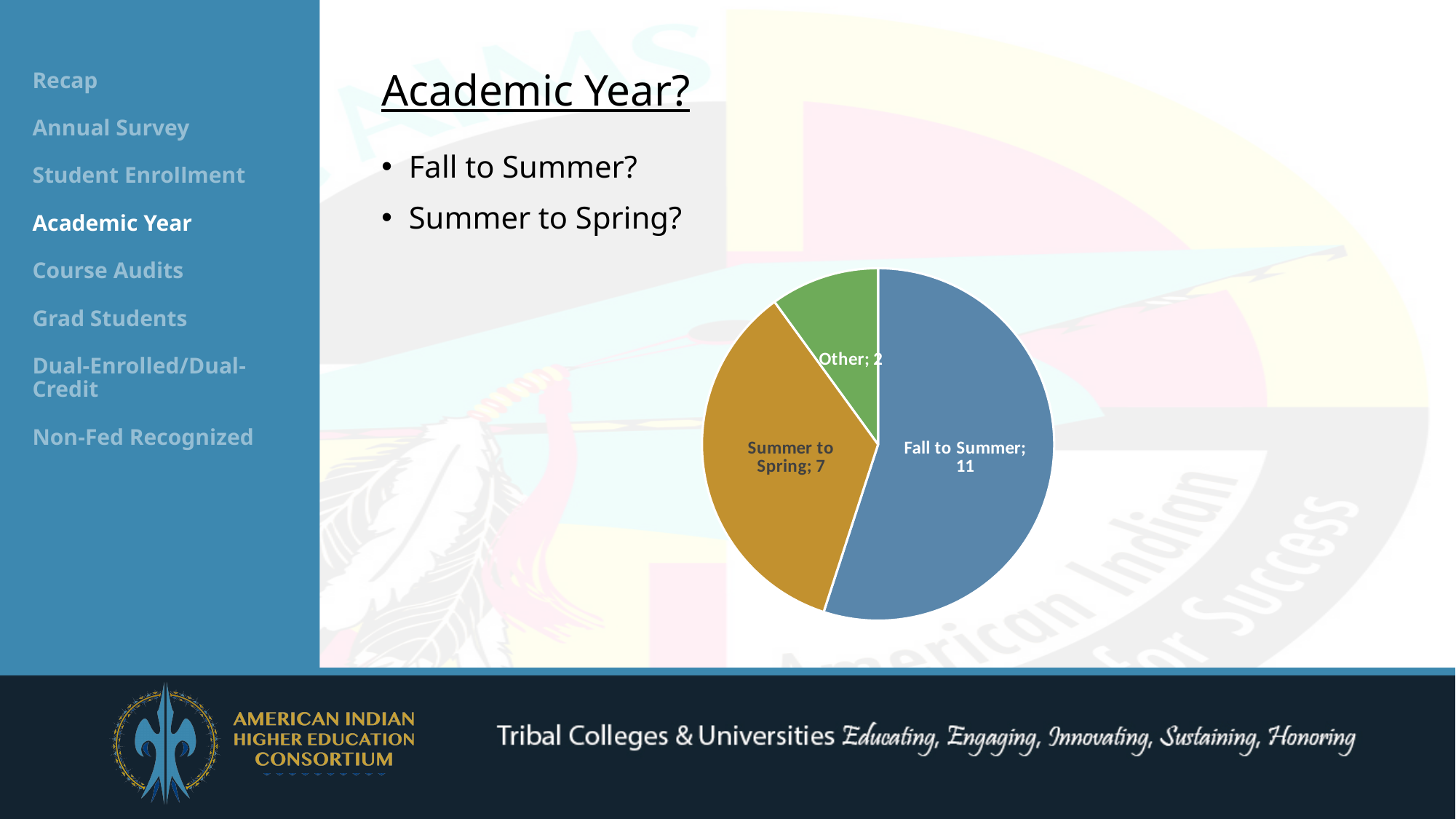
What kind of chart is shown on the slide? Pie chart What is the difference between the Fall to Summer and Summer to Spring values? 4 What is the total of all slices in the pie chart? 20 Which is larger, Summer to Spring or Other? Summer to Spring Which slice of the pie chart is the largest? Fall to Summer What is the value for Summer to Spring in the pie chart? 7 How many slices does the pie chart have? 3 What is the value for Other in the pie chart? 2 What share of the pie does Fall to Summer represent? 55% What is the value for Fall to Summer in the pie chart? 11 What colour is the Summer to Spring slice in the pie chart? Gold Which slice of the pie chart is the smallest? Other